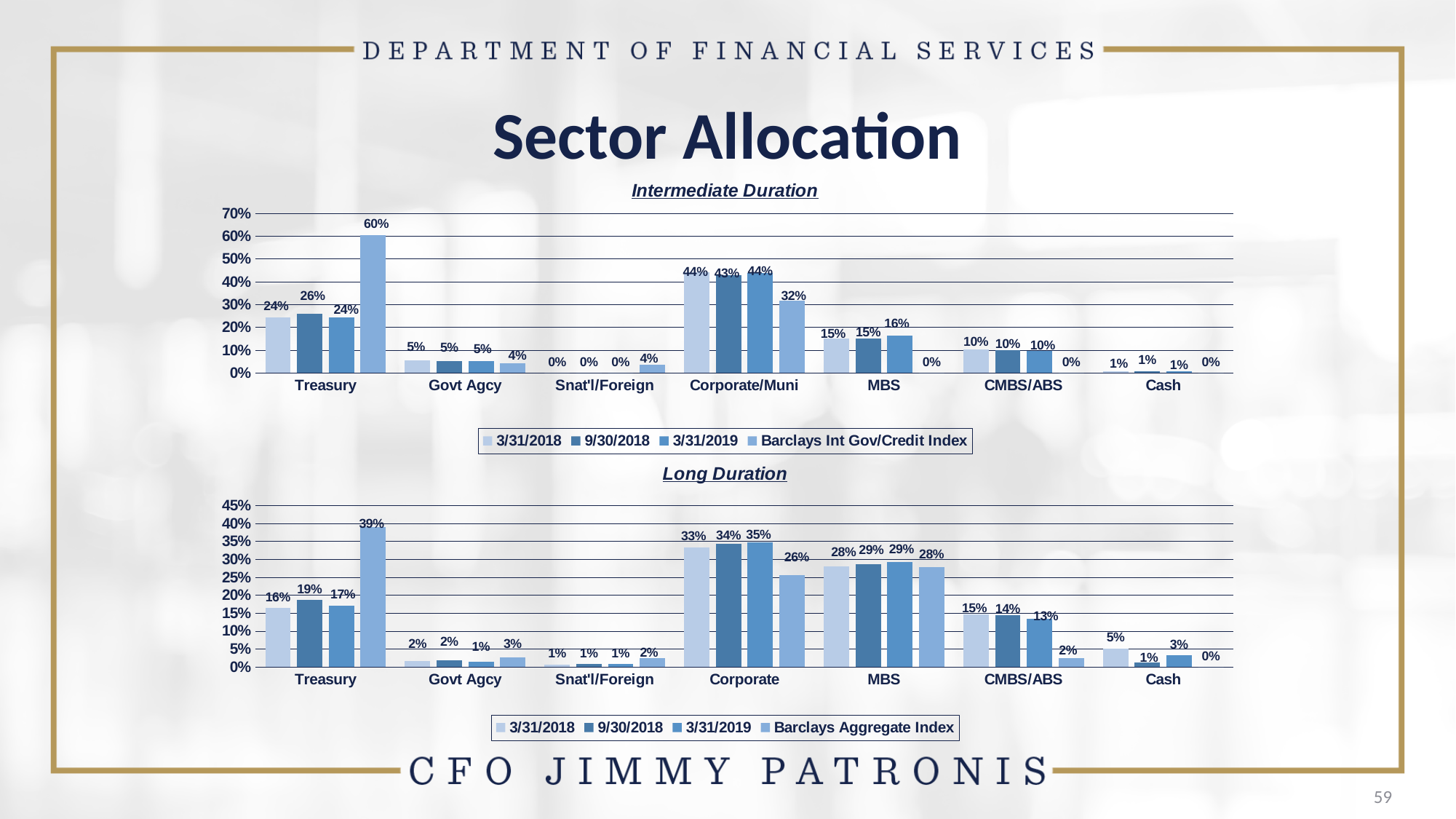
In the Long Duration chart, what is the value for Cash on 3/31/2018? 5% In the Long Duration chart, what is the difference between the 3/31/2018 and 3/31/2019 values for CMBS/ABS? 2% In the Intermediate Duration chart, what is the difference between the Barclays Int Gov/Credit Index value for Treasury and its value for Corporate/Muni? 28% In the Intermediate Duration chart, what is the value for Corporate/Muni on 9/30/2018? 43% In the Long Duration chart, which is larger for Treasury: the 9/30/2018 value or the 3/31/2019 value? 9/30/2018 What type of chart is the Long Duration chart? Bar chart In the Long Duration chart, what is the value for MBS on 3/31/2019? 29% In the Long Duration chart, which category has the lowest value in the Barclays Aggregate Index series? Cash In the Intermediate Duration chart, which category has the highest value for the 3/31/2019 series? Corporate/Muni In the Intermediate Duration chart, what is the value for Treasury in the Barclays Int Gov/Credit Index series? 60% How many categories are shown on the x axis of the Long Duration chart? 7 How many series does the legend of the Intermediate Duration chart list? 4